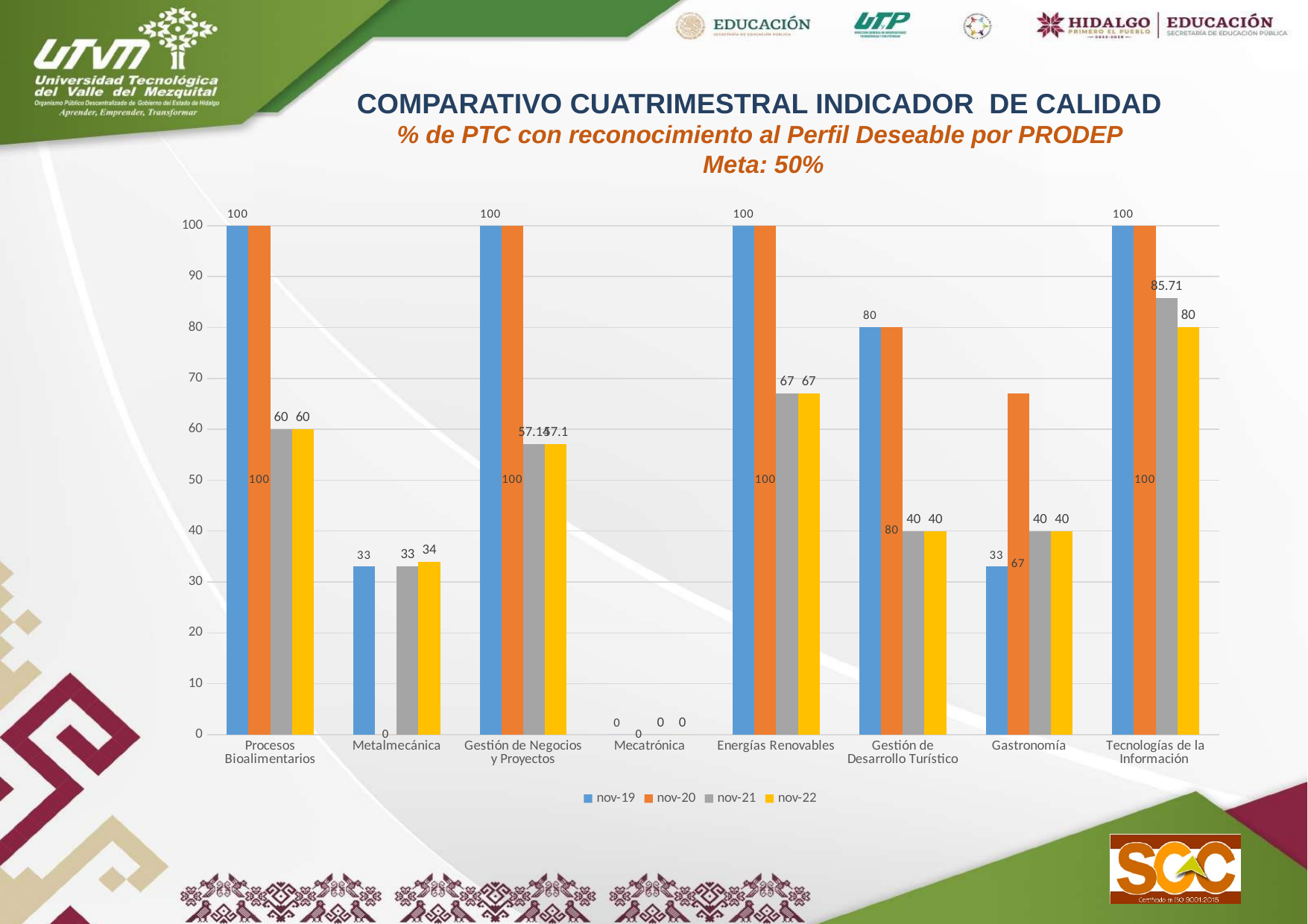
What is the nov-20 value for Gastronomía? 67 What kind of chart is shown on the slide? Bar chart How many series does the legend list? 4 What target (Meta) is stated in the chart title? 50% How many categories are shown on the x axis? 8 What is the nov-22 value for Tecnologías de la Información? 80 Which category has the lowest nov-22 value? Mecatrónica Which category has the highest nov-22 value? Tecnologías de la Información What is the nov-21 value for Tecnologías de la Información? 85.71 What is the nov-21 value for Gestión de Negocios y Proyectos? 57.14 What is the difference between the nov-20 and nov-19 values for Gastronomía? 34 Which is larger, the nov-22 value for Energías Renovables or the nov-22 value for Procesos Bioalimentarios? Energías Renovables